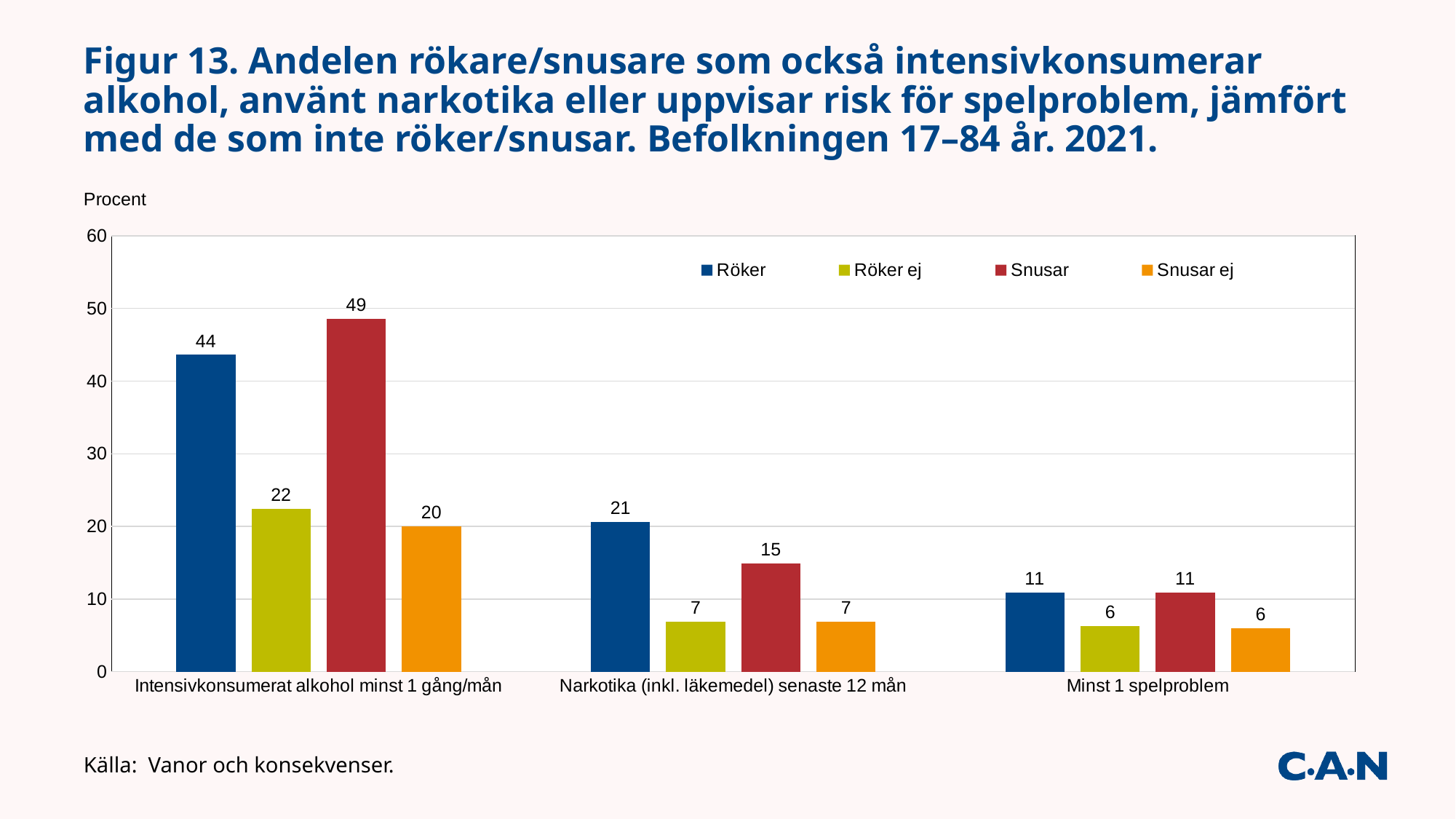
Which series has the lowest value in the category Narkotika (inkl. läkemedel) senaste 12 mån? Röker ej and Snusar ej (both 7) What is the value for Snusar ej in the category Narkotika (inkl. läkemedel) senaste 12 mån? 7 What is the label on the y axis? Procent How many categories are shown on the x axis? 3 What is the value for Röker ej in the category Minst 1 spelproblem? 6 Is the value for Röker in the category Intensivkonsumerat alkohol minst 1 gång/mån greater or less than 40? greater What is the difference between the Snusar and Snusar ej values in the category Intensivkonsumerat alkohol minst 1 gång/mån? 29 What is the value for Röker in the category Intensivkonsumerat alkohol minst 1 gång/mån? 44 How many series does the legend list? 4 Which is larger in the category Narkotika (inkl. läkemedel) senaste 12 mån: the value for Röker or the value for Snusar? Röker What kind of chart is shown on the slide? Bar chart Which series has the highest value in the category Intensivkonsumerat alkohol minst 1 gång/mån? Snusar